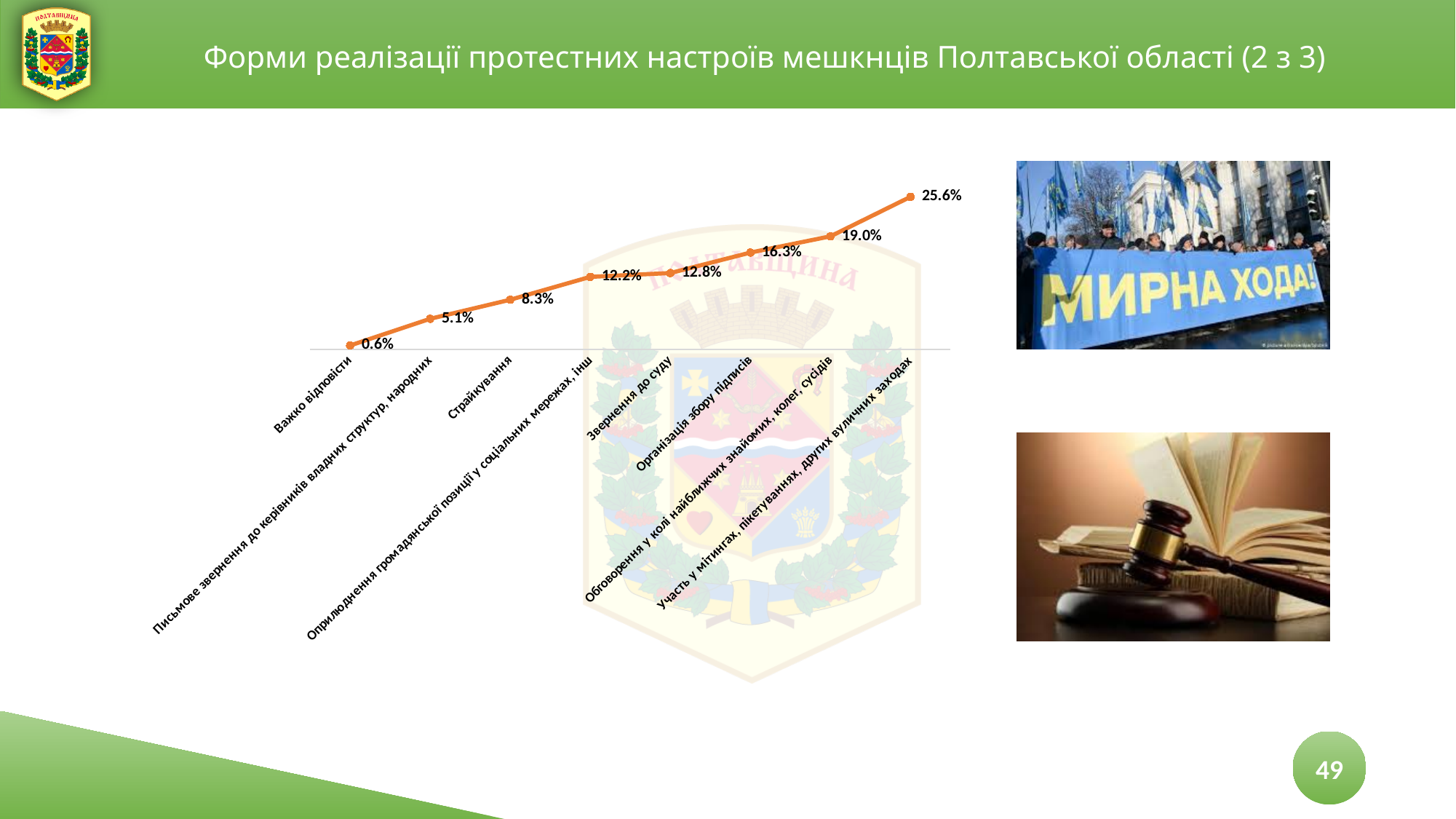
Do the values rise or fall from left to right along the x axis? Rise What is the value for "Страйкування"? 8.3% Which category has the lowest value? Важко відповісти How many categories are plotted on the chart? 8 What colour is the line on the chart? Orange What kind of chart is shown on the slide? Line chart Which is larger: the value for "Страйкування" or the value for "Організація збору підписів"? Організація збору підписів What is the difference between the values for "Участь у мітингах, пікетуваннях, других вуличних заходах" and "Обговорення у колі найближчих знайомих, колег, сусідів"? 6.6% Which category has the highest value? Участь у мітингах, пікетуваннях, других вуличних заходах What is the value for "Важко відповісти"? 0.6% What is the value for "Звернення до суду"? 12.8% What is the value for "Організація збору підписів"? 16.3%